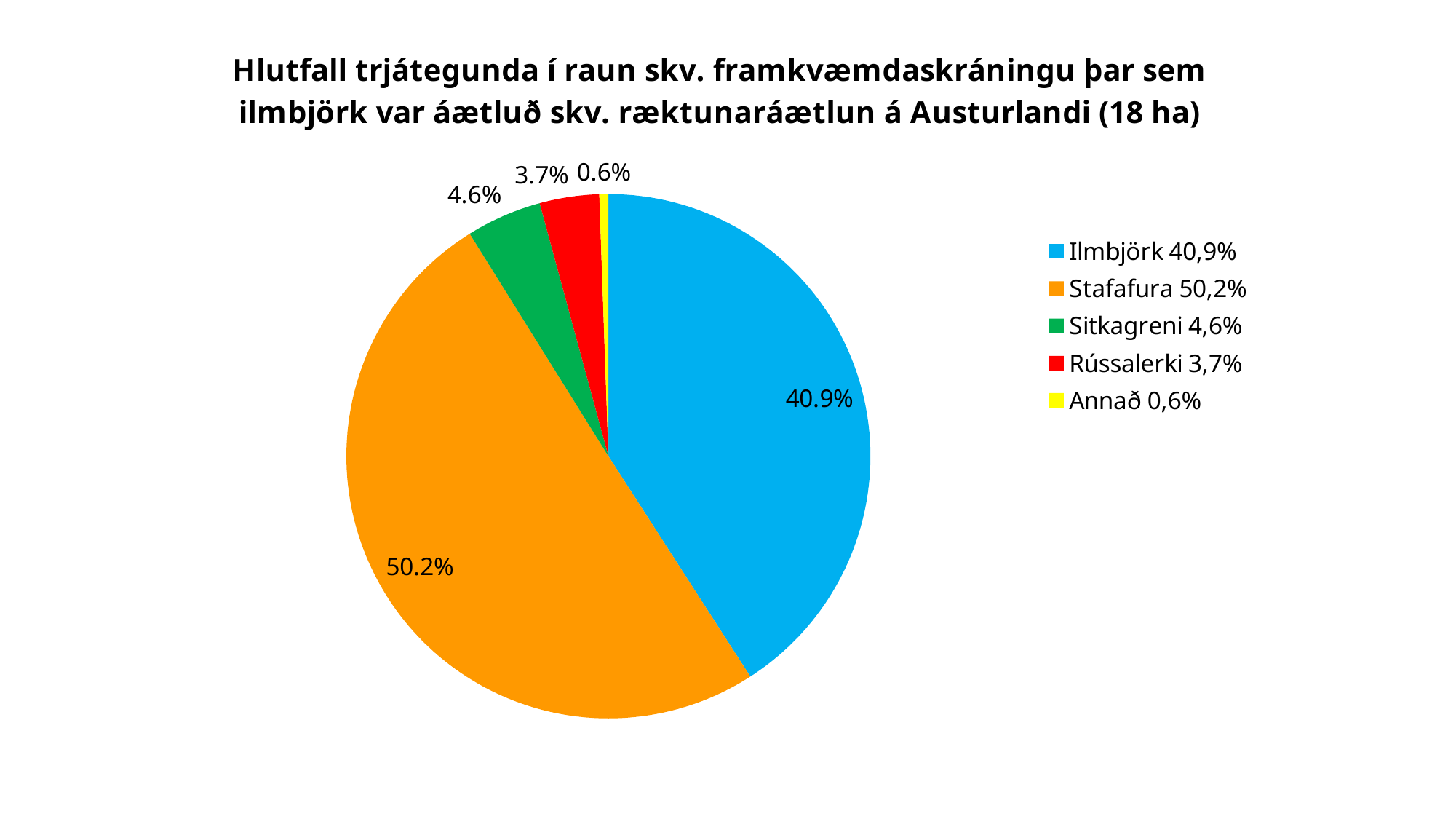
What share of the pie does Annað have? 0.6% What share of the pie does Sitkagreni have? 4.6% What colour is the slice for Rússalerki? red What share of the pie does Ilmbjörk have? 40.9% How many categories does the pie chart have? 5 Which is larger, the share for Sitkagreni or the share for Rússalerki? Sitkagreni What is the difference between the shares of Stafafura and Ilmbjörk? 9.3% What kind of chart is shown on the slide? pie chart Which category has the largest slice of the pie? Stafafura Which category has the smallest slice of the pie? Annað